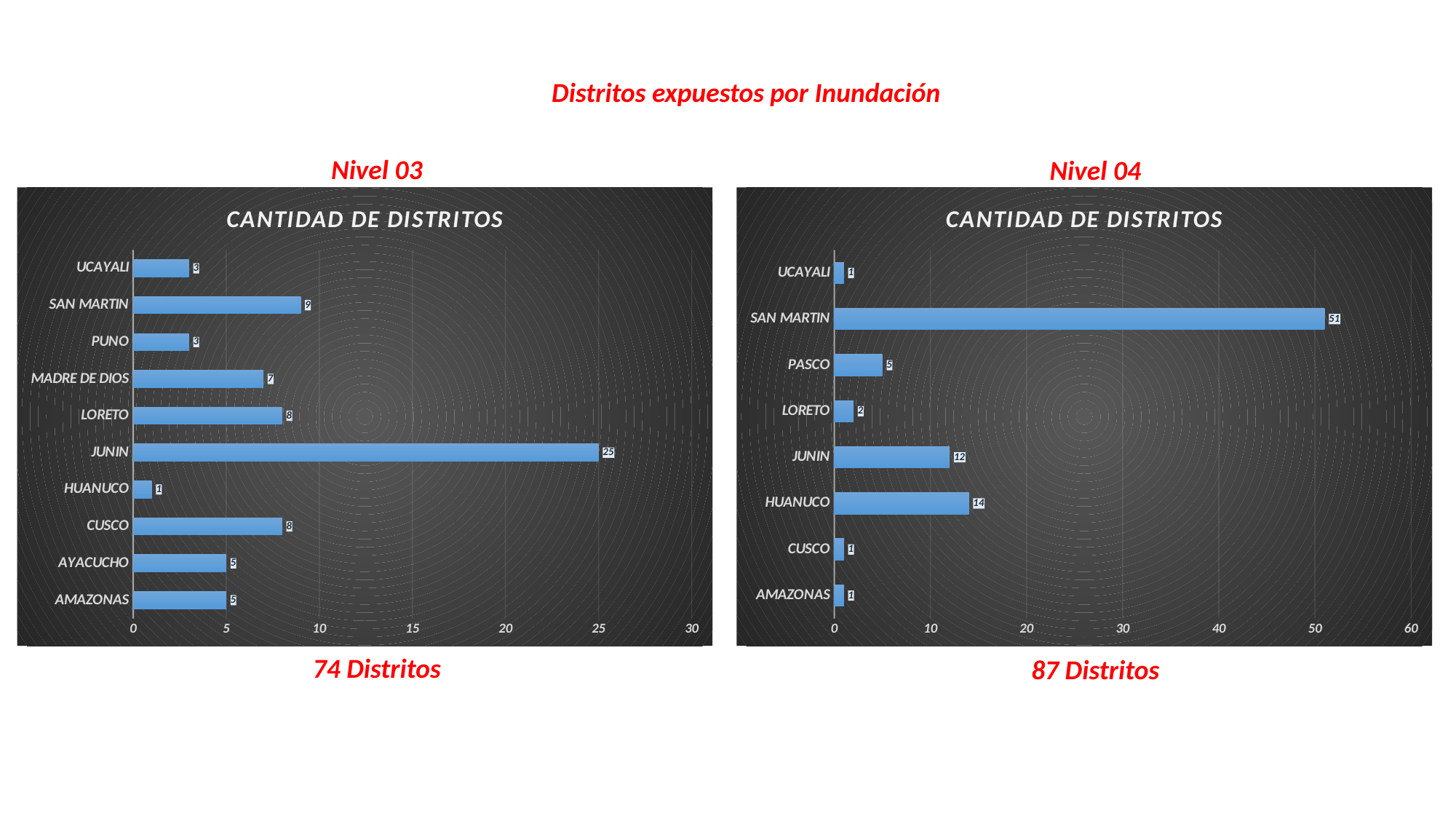
In the Nivel 03 chart, what is the value for JUNIN? 25 In the Nivel 04 chart, which category has the highest value? SAN MARTIN How many categories are shown in the Nivel 04 chart? 8 In the Nivel 03 chart, which category has the highest value? JUNIN What kind of chart is the Nivel 03 chart? Bar chart In the Nivel 03 chart, which is larger, the value for SAN MARTIN or the value for LORETO? SAN MARTIN In the Nivel 04 chart, what is the value for SAN MARTIN? 51 In the Nivel 03 chart, which category has the lowest value? HUANUCO How many categories are shown in the Nivel 03 chart? 10 In the Nivel 04 chart, what is the value for HUANUCO? 14 In the Nivel 03 chart, what is the value for MADRE DE DIOS? 7 In the Nivel 04 chart, what is the difference between the values for HUANUCO and JUNIN? 2